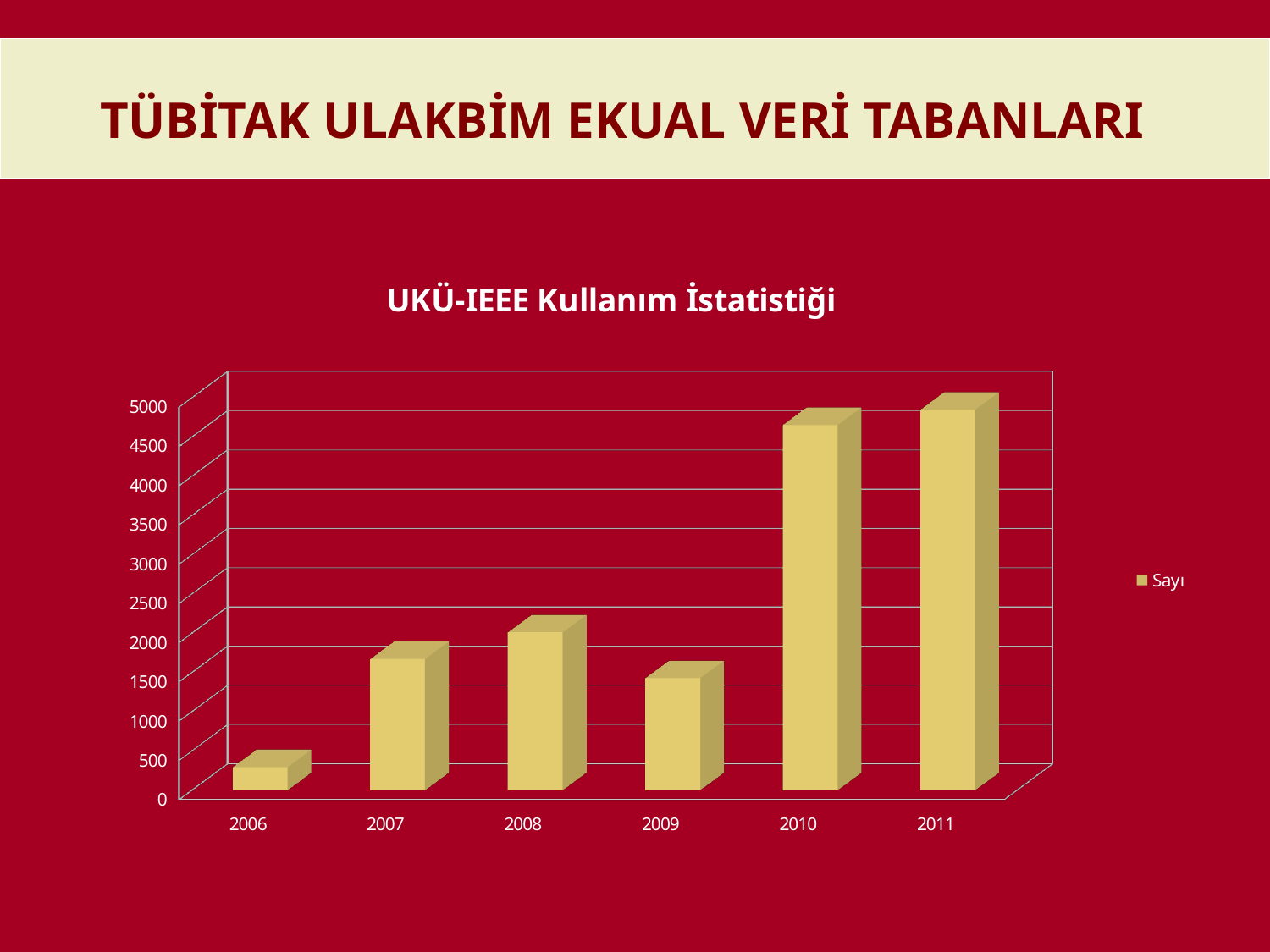
Is the value for 2010 greater or less than 4500? greater Is the value for 2006 greater or less than 500? less How many years are shown on the x axis of the chart? 6 Is the value for 2007 greater or less than 1500? greater What is the title of the chart? UKÜ-IEEE Kullanım İstatistiği Do the values rise or fall from 2009 to 2011? rise Which year has the highest value in the chart? 2011 Which year has the lowest value in the chart? 2006 What kind of chart is shown on the slide? bar chart How many series does the legend list? 1 Which year has the larger value, 2008 or 2009? 2008